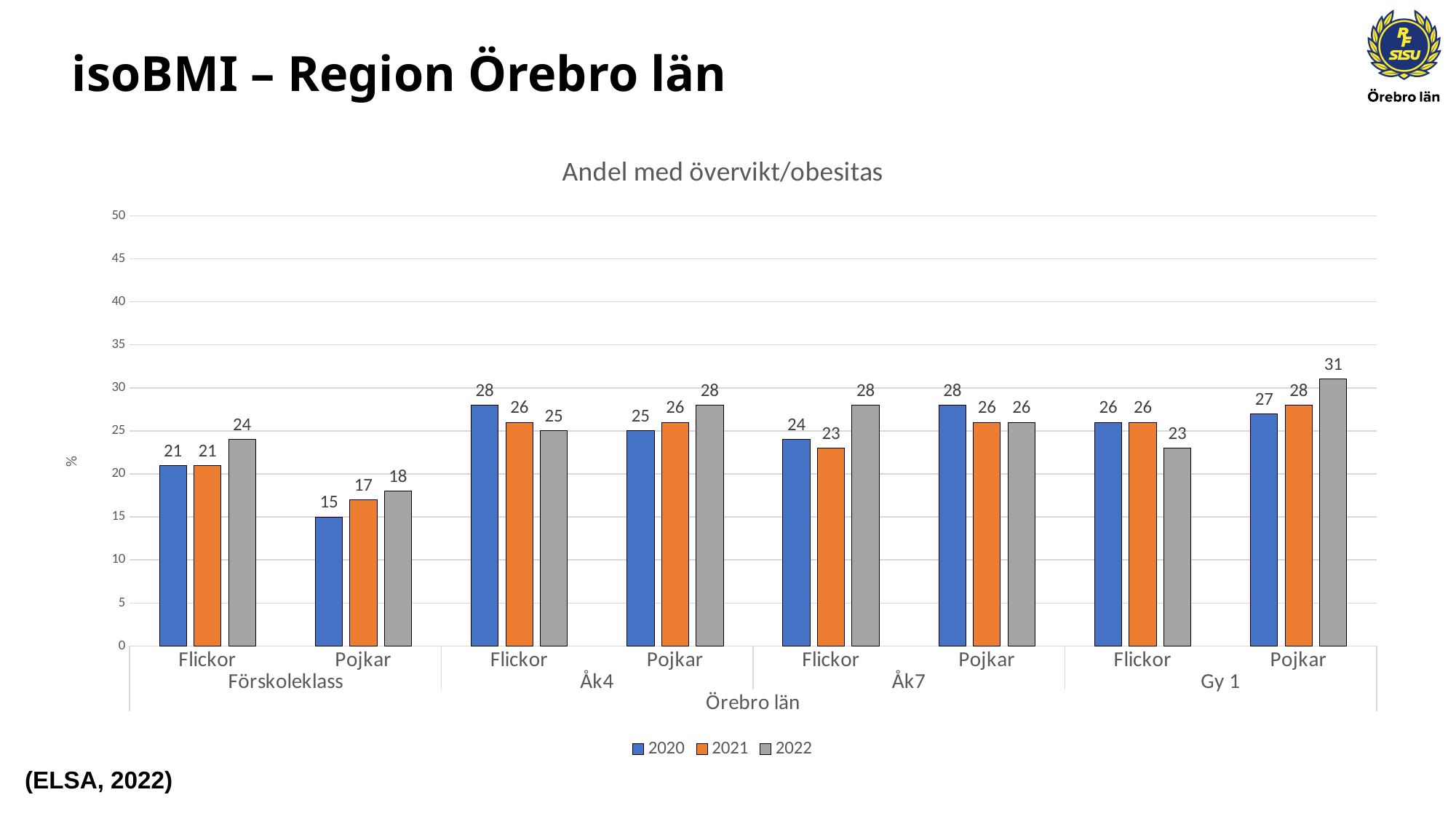
Do the values for Pojkar in Förskoleklass rise or fall from 2020 to 2022? Rise Is the 2022 value for Pojkar in Gy 1 greater or less than 30? greater What is the value for Pojkar in Förskoleklass for 2020? 15 How many series does the legend list? 3 What is the value for Pojkar in Gy 1 for 2022? 31 What is the difference between the 2022 and 2020 values for Pojkar in Förskoleklass? 3 What is the title of the chart? Andel med övervikt/obesitas Which is larger for Flickor in Gy 1: the 2020 value or the 2022 value? 2020 Which group and year has the highest value in the chart? Pojkar, Gy 1, 2022 What kind of chart is shown on the slide? Bar chart What is the value for Flickor in Åk7 for 2022? 28 Which group and year has the lowest value in the chart? Pojkar, Förskoleklass, 2020